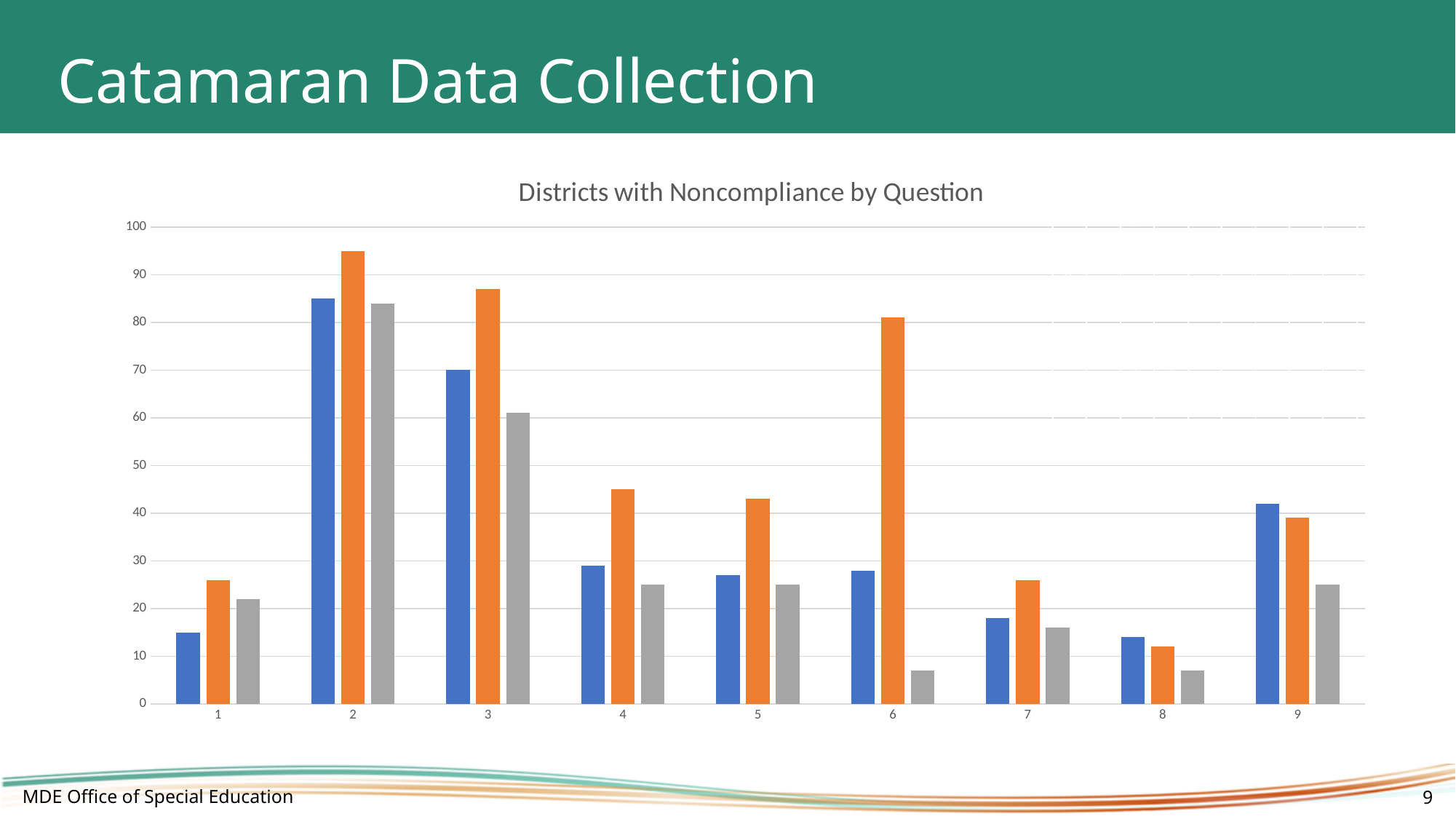
Is the value of the gray bar for question 6 greater or less than 10? less For question 3, which is larger: the blue bar or the orange bar? the orange bar Is the value of the blue bar for question 1 greater or less than 20? less Is the value of the orange bar for question 2 greater or less than 90? greater How many bars are plotted for each question category? 3 Which question category has the tallest bar in the chart? 2 What kind of chart is shown on the slide? bar chart Which colours are used for the three bars in each category? blue, orange and gray How many question categories are shown on the x axis? 9 What is the title of the chart? Districts with Noncompliance by Question For question 6, which is larger: the blue bar or the gray bar? the blue bar